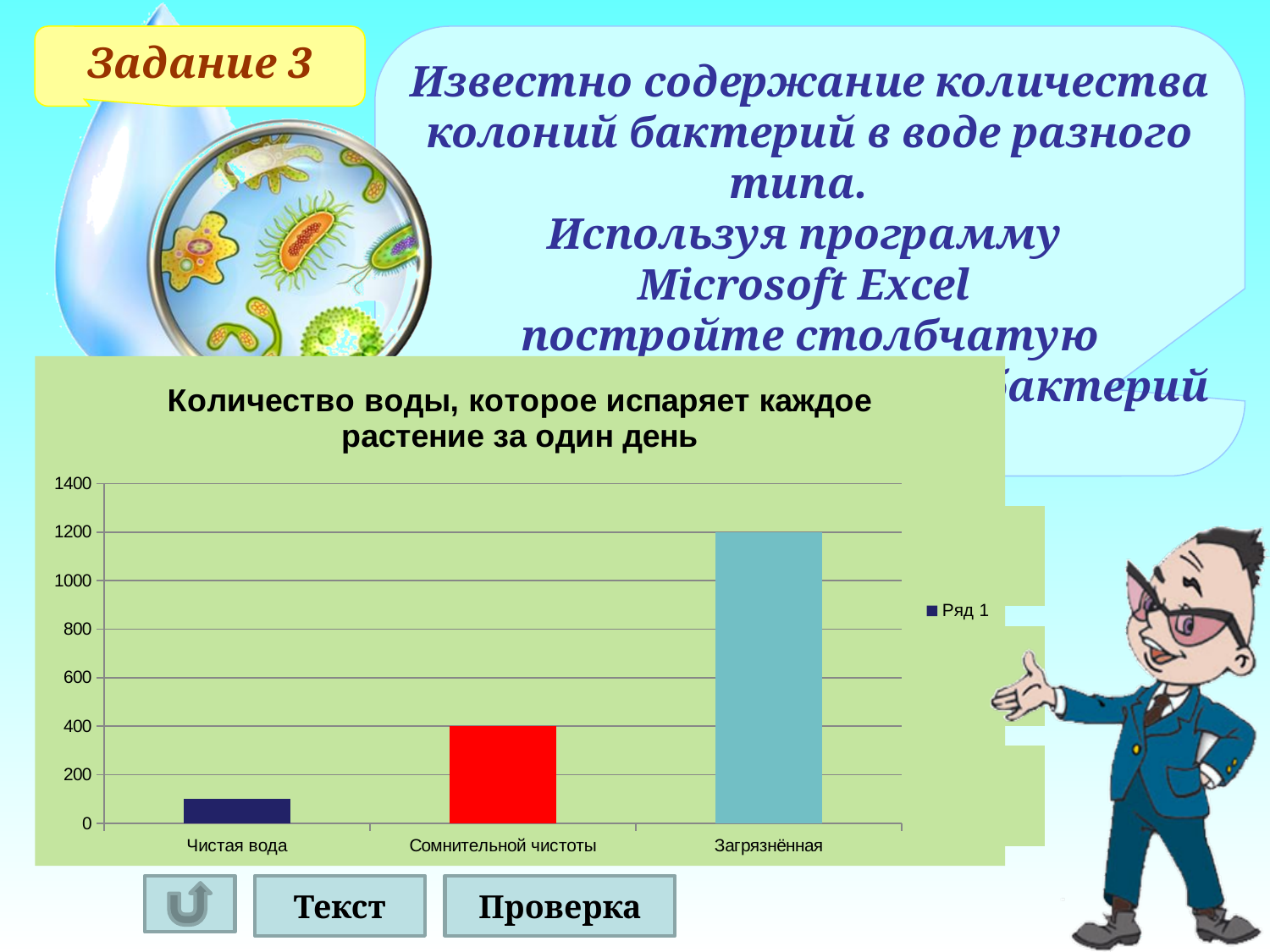
How many categories are shown on the x axis? 3 Is the value for Загрязнённая greater or less than 1000? greater Which category has the lowest value? Чистая вода What is the title of the chart? Количество воды, которое испаряет каждое растение за один день What is the difference between the values for Загрязнённая and Сомнительной чистоты? 800 Which category has the highest value? Загрязнённая Is the value for Чистая вода greater or less than 200? less What is the value for Загрязнённая? 1200 How many series does the legend list? 1 Which is larger, the value for Сомнительной чистоты or the value for Чистая вода? Сомнительной чистоты What is the value for Сомнительной чистоты? 400 What type of chart is shown on the slide? bar chart